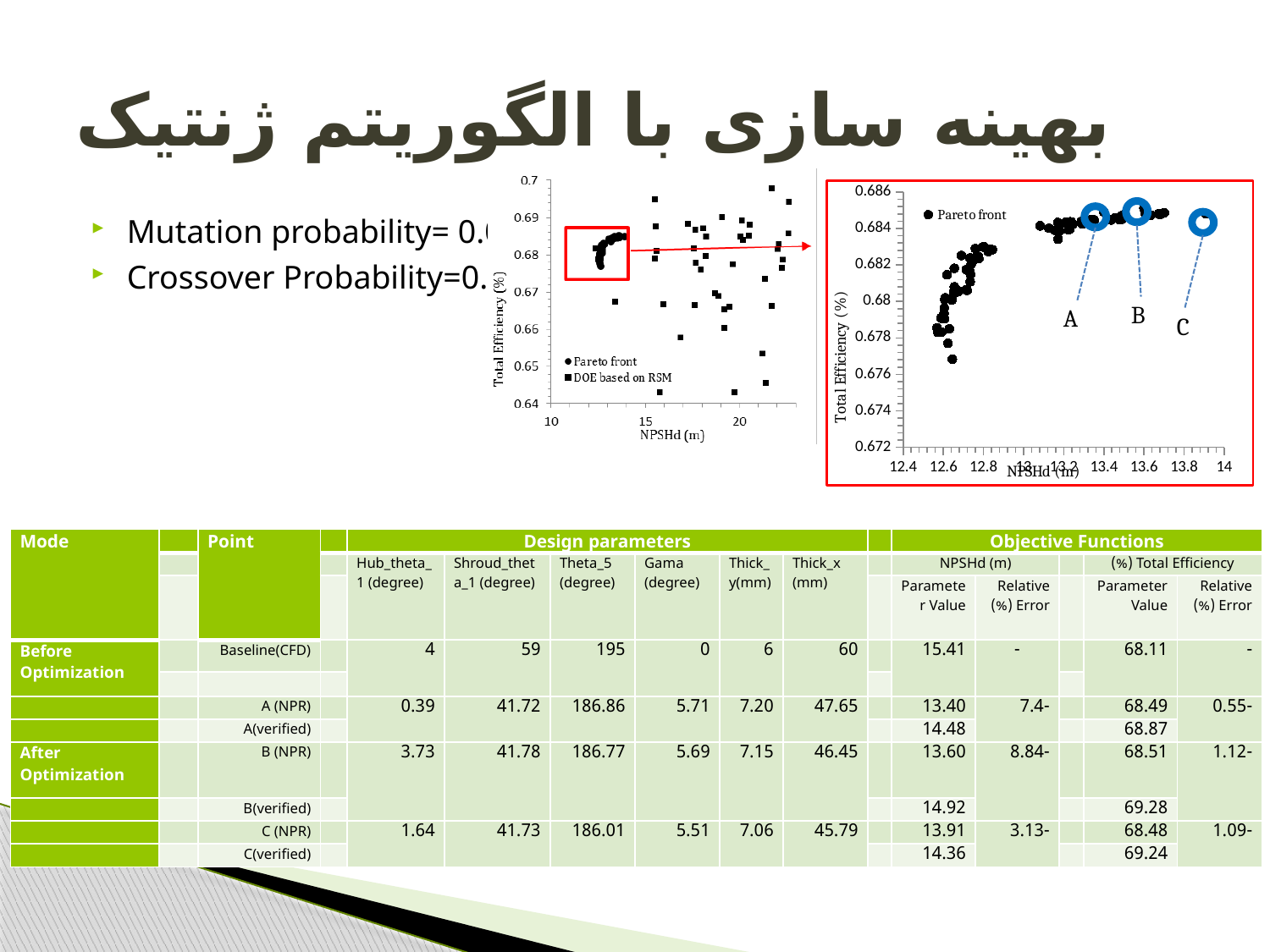
In the right chart (red-bordered), is the Total Efficiency value for point C greater or less than 0.68? greater What are the two series named in the legend of the left chart? Pareto front and DOE based on RSM In the right chart (red-bordered), how many points are marked with letter labels? 3 How many series does the legend of the left chart list? 2 In the right chart (red-bordered), is the NPSHd value for point C greater or less than 13.6? greater What is the x-axis label of the right chart (red-bordered)? NPSHd (m) What kind of chart is the left chart with the 'DOE based on RSM' series? Scatter chart In the right chart (red-bordered), which of points A and C has the larger NPSHd value? C In the left chart, is the Total Efficiency of the lowest 'DOE based on RSM' point greater or less than 0.65? less How many series does the legend of the right chart (red-bordered) list? 1 In the right chart (red-bordered), does the Pareto front's Total Efficiency generally rise or fall as NPSHd increases? rise